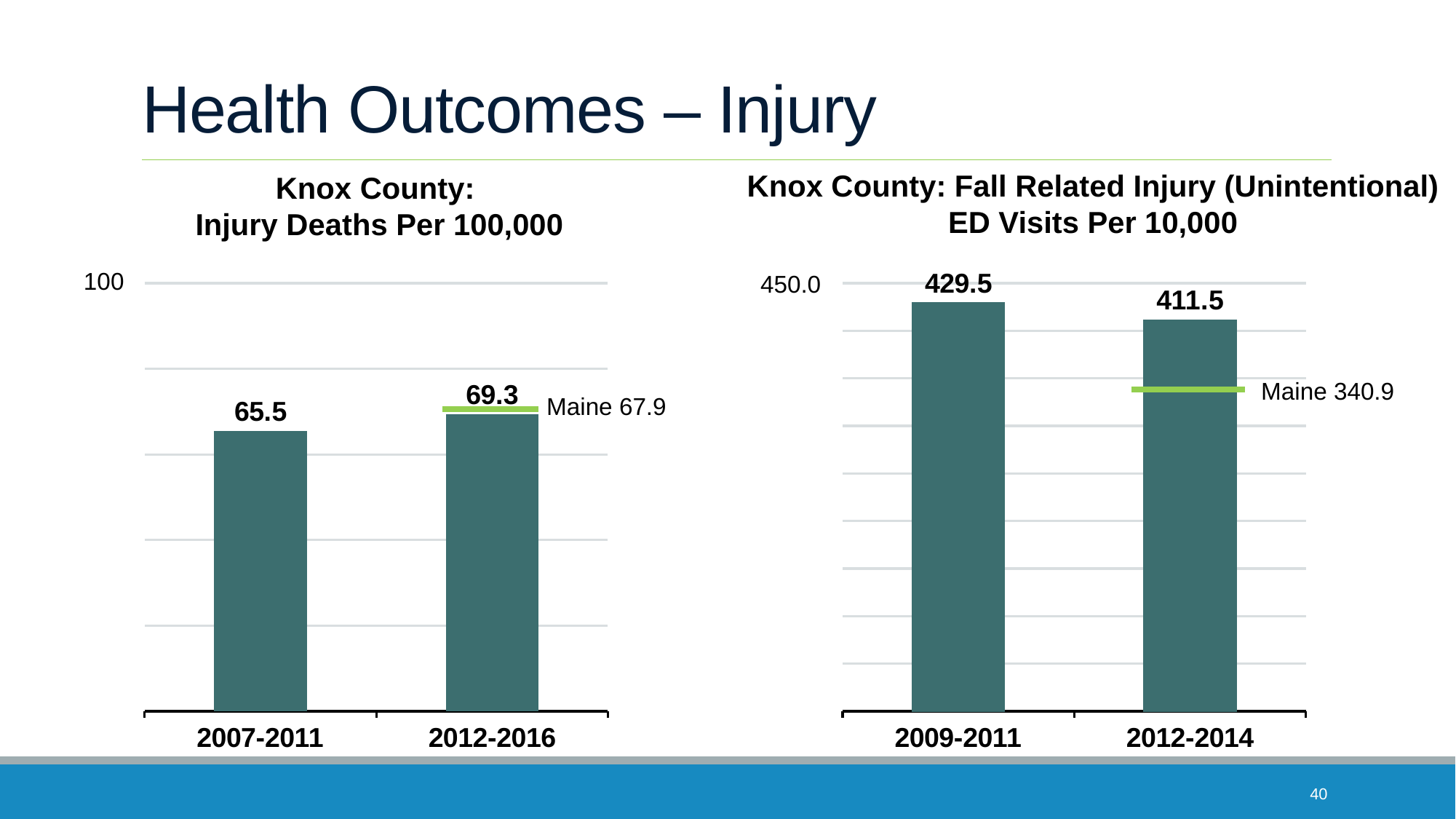
In the 'Knox County: Injury Deaths Per 100,000' chart, do the values rise or fall from 2007-2011 to 2012-2016? rise In the 'Knox County: Fall Related Injury (Unintentional) ED Visits Per 10,000' chart, what is the Maine value shown by the reference line? 340.9 In the 'Knox County: Injury Deaths Per 100,000' chart, what is the value for 2012-2016? 69.3 In the 'Knox County: Injury Deaths Per 100,000' chart, what is the difference between the 2012-2016 and 2007-2011 values? 3.8 In the 'Knox County: Fall Related Injury (Unintentional) ED Visits Per 10,000' chart, what is the value for 2009-2011? 429.5 In the 'Knox County: Fall Related Injury (Unintentional) ED Visits Per 10,000' chart, what is the difference between the 2009-2011 and 2012-2014 values? 18.0 In the 'Knox County: Injury Deaths Per 100,000' chart, what is the value for 2007-2011? 65.5 In the 'Knox County: Fall Related Injury (Unintentional) ED Visits Per 10,000' chart, which period has the higher value? 2009-2011 What type of chart is the 'Knox County: Injury Deaths Per 100,000' chart? bar chart How many bars are in the 'Knox County: Fall Related Injury (Unintentional) ED Visits Per 10,000' chart? 2 In the 'Knox County: Injury Deaths Per 100,000' chart, what is the Maine value shown by the reference line? 67.9 In the 'Knox County: Fall Related Injury (Unintentional) ED Visits Per 10,000' chart, what is the value for 2012-2014? 411.5